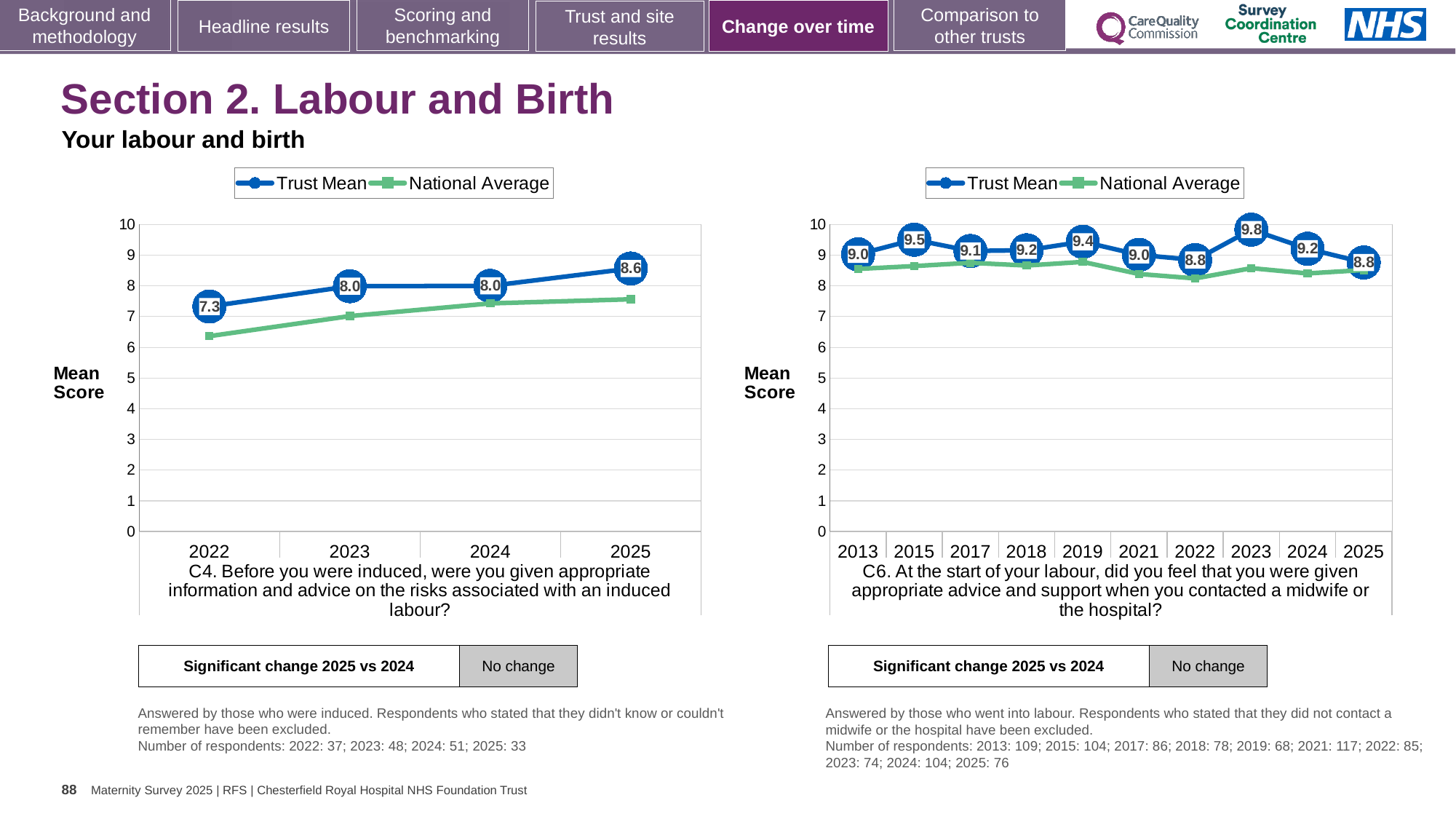
In the left chart (C4), what is the Trust Mean for 2025? 8.6 In the left chart (C4), what is the Trust Mean for 2022? 7.3 How many series does the legend of the right chart (C6) list? 2 In the left chart (C4), how many years are shown on the x axis? 4 In the right chart (C6), what is the Trust Mean for 2023? 9.8 In the right chart (C6), what is the Trust Mean for 2025? 8.8 In the right chart (C6), how many years are shown on the x axis? 10 In the right chart (C6), which year has the highest Trust Mean? 2023 In the left chart (C4), what is the difference between the Trust Mean in 2025 and in 2022? 1.3 In the left chart (C4), does the Trust Mean rise or fall from 2022 to 2025? rise In the left chart (C4), is the National Average for 2022 greater or less than 7? less In the right chart (C6), which is larger, the Trust Mean for 2015 or for 2021? 2015